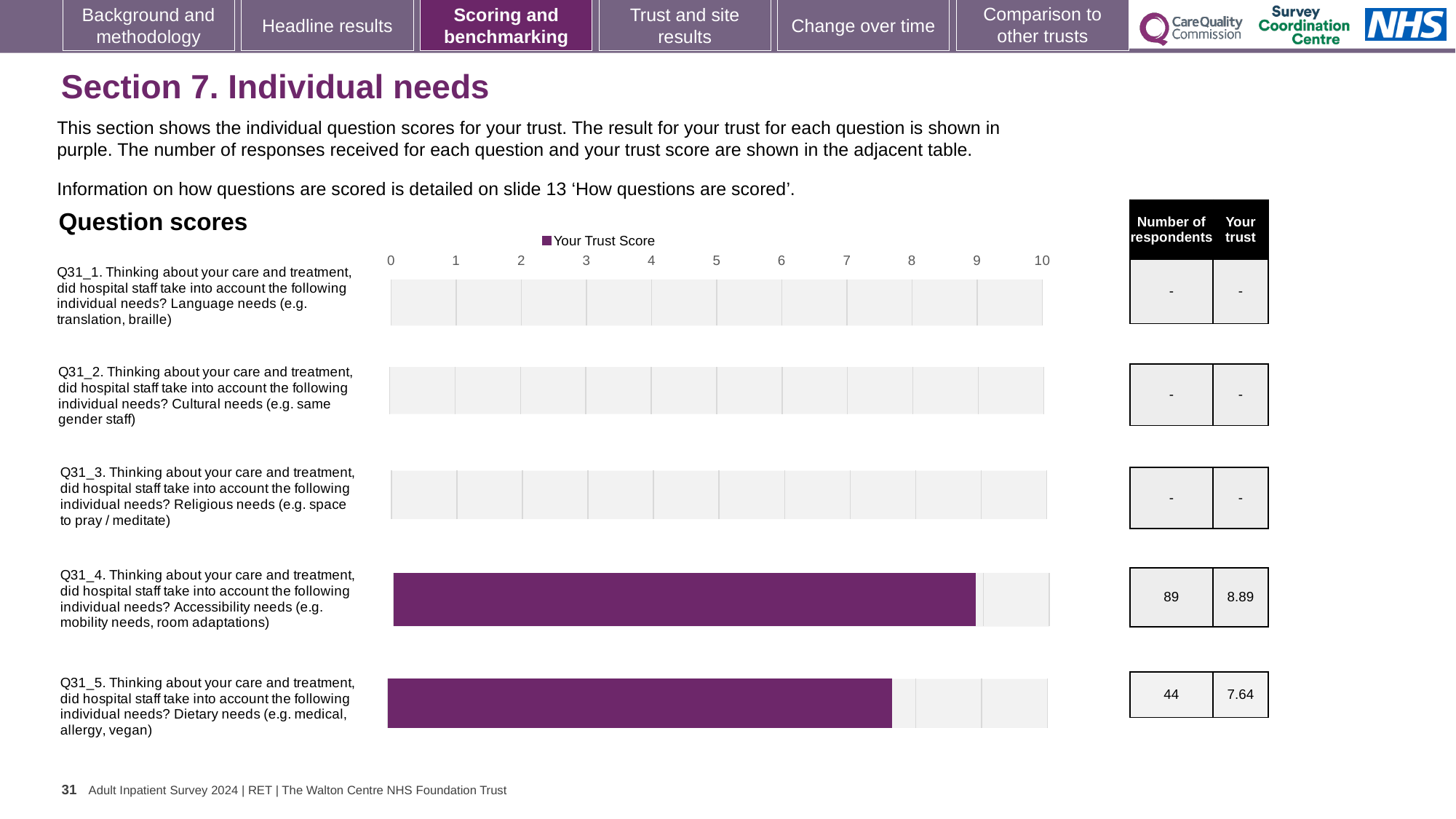
How many respondents answered Q31_5 (Dietary needs)? 44 Which has the larger trust score, Q31_4 (Accessibility needs) or Q31_5 (Dietary needs)? Q31_4 (Accessibility needs) What type of chart is shown on the slide? Bar chart Which question has the highest trust score on the chart? Q31_4 (Accessibility needs) What is the name of the series shown in the chart legend? Your Trust Score What is the trust score for Q31_5 (Dietary needs)? 7.64 What is the difference between the trust scores for Q31_4 and Q31_5? 1.25 How many questions are listed on the chart? 5 Is the trust score for Q31_5 (Dietary needs) greater or less than 8? less What is the trust score for Q31_4 (Accessibility needs)? 8.89 How many respondents answered Q31_4 (Accessibility needs)? 89 Is the trust score for Q31_4 (Accessibility needs) greater or less than 8? greater